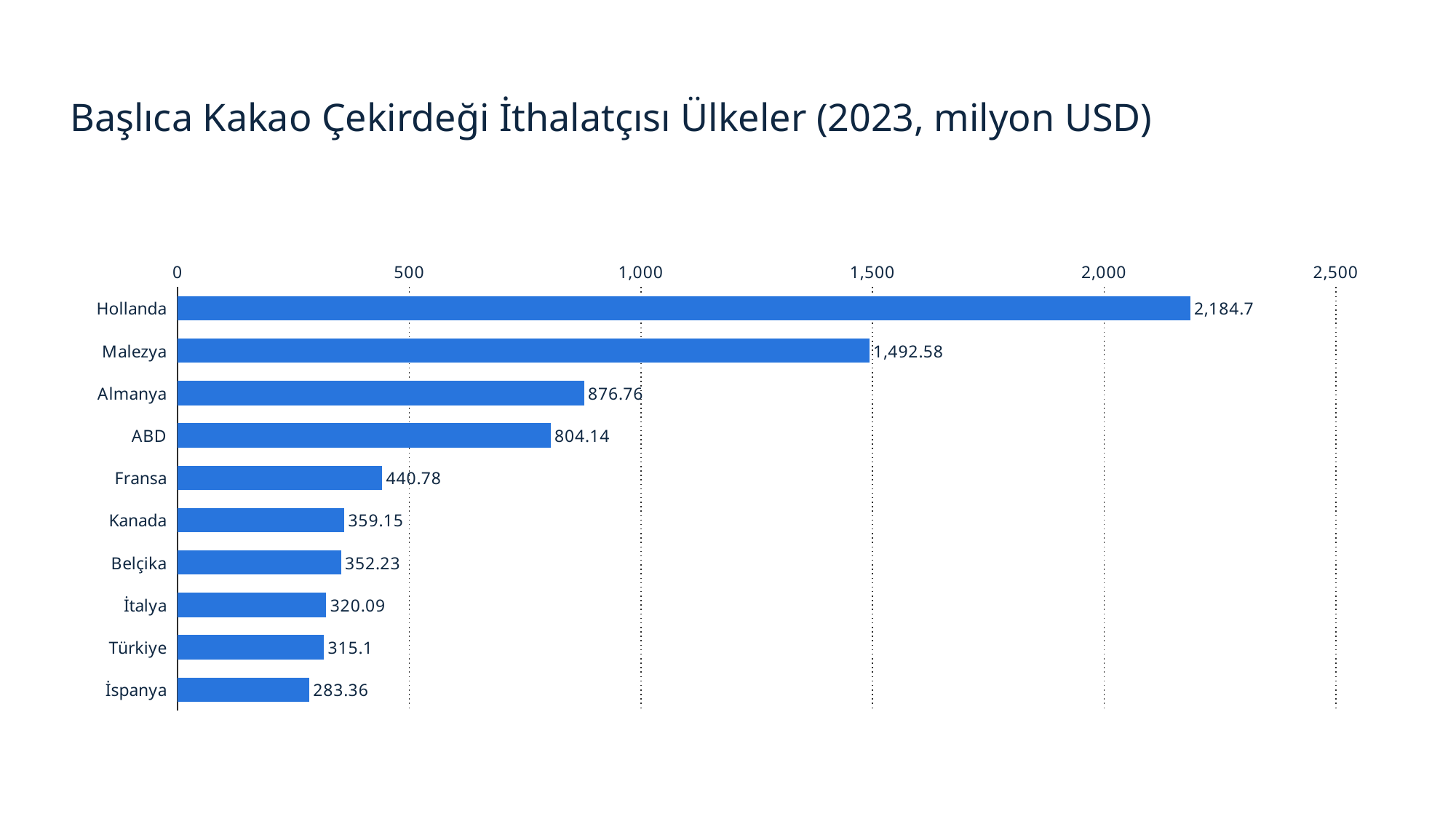
What is the difference between the values for Hollanda and Malezya? 692.12 What kind of chart is shown on the slide? Bar chart What is the value for Hollanda? 2,184.7 What is the difference between the values for Almanya and ABD? 72.62 What is the value for Türkiye? 315.1 What is the title of the chart? Başlıca Kakao Çekirdeği İthalatçısı Ülkeler (2023, milyon USD) Is the value for Malezya greater or less than 1,000? greater Which country has the highest value? Hollanda Which country has the lowest value? İspanya Which is larger, the value for Kanada or the value for İtalya? Kanada How many countries are shown in the chart? 10 What is the value for Fransa? 440.78